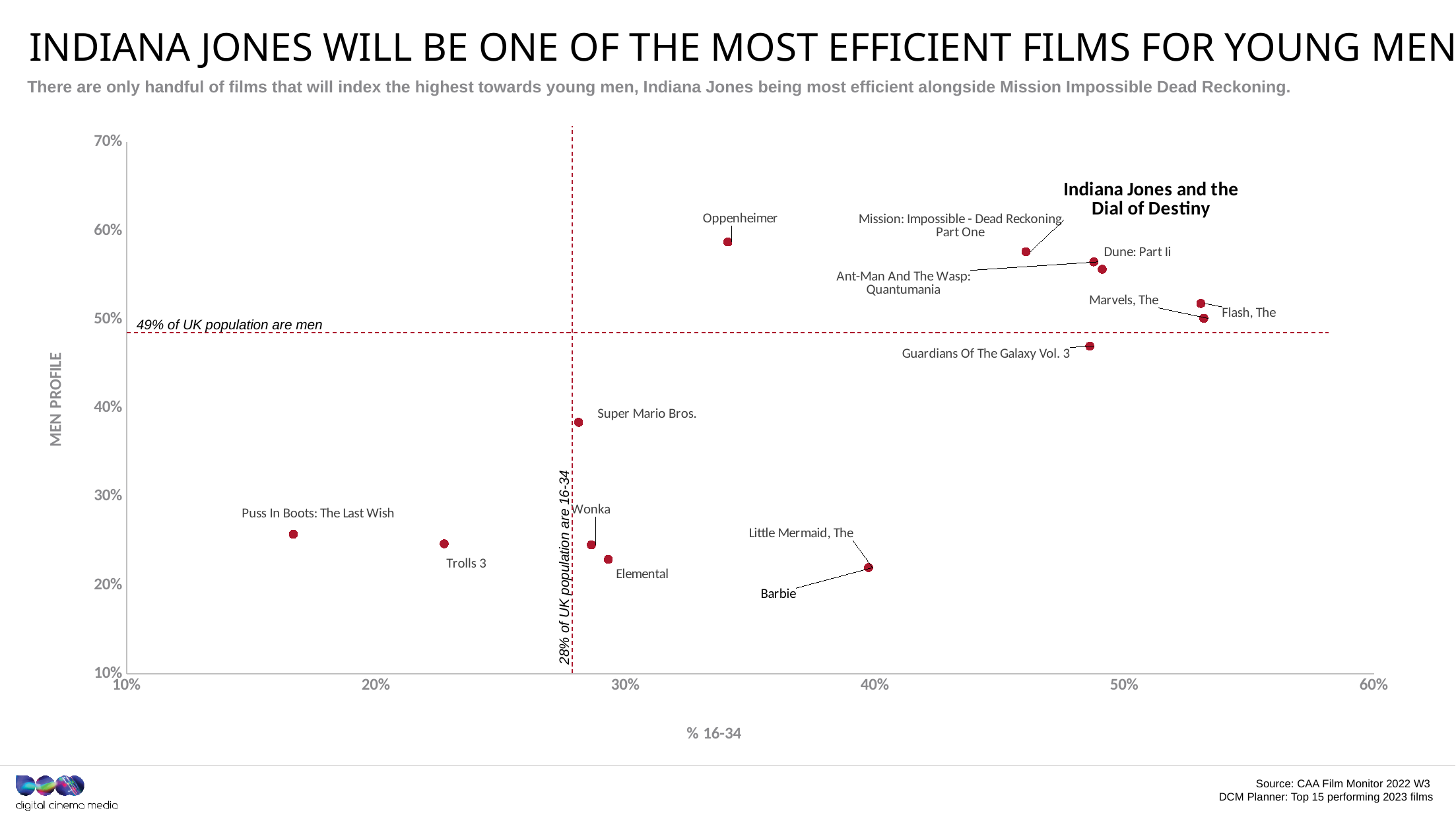
Is the men profile value for Oppenheimer greater or less than 50%? greater Which film has the lowest % 16-34 value? Puss In Boots: The Last Wish Which has the higher % 16-34 value, Oppenheimer or Elemental? Oppenheimer How many films are labelled on the chart? 15 Is the % 16-34 value for Trolls 3 greater or less than 20%? greater Is the men profile value for Super Mario Bros. greater or less than 30%? greater What kind of chart is shown on the slide? Scatter chart What does the horizontal dashed reference line on the chart represent? 49% of UK population are men Which has the higher men profile value, Super Mario Bros. or Wonka? Super Mario Bros. What is the label of the horizontal axis? % 16-34